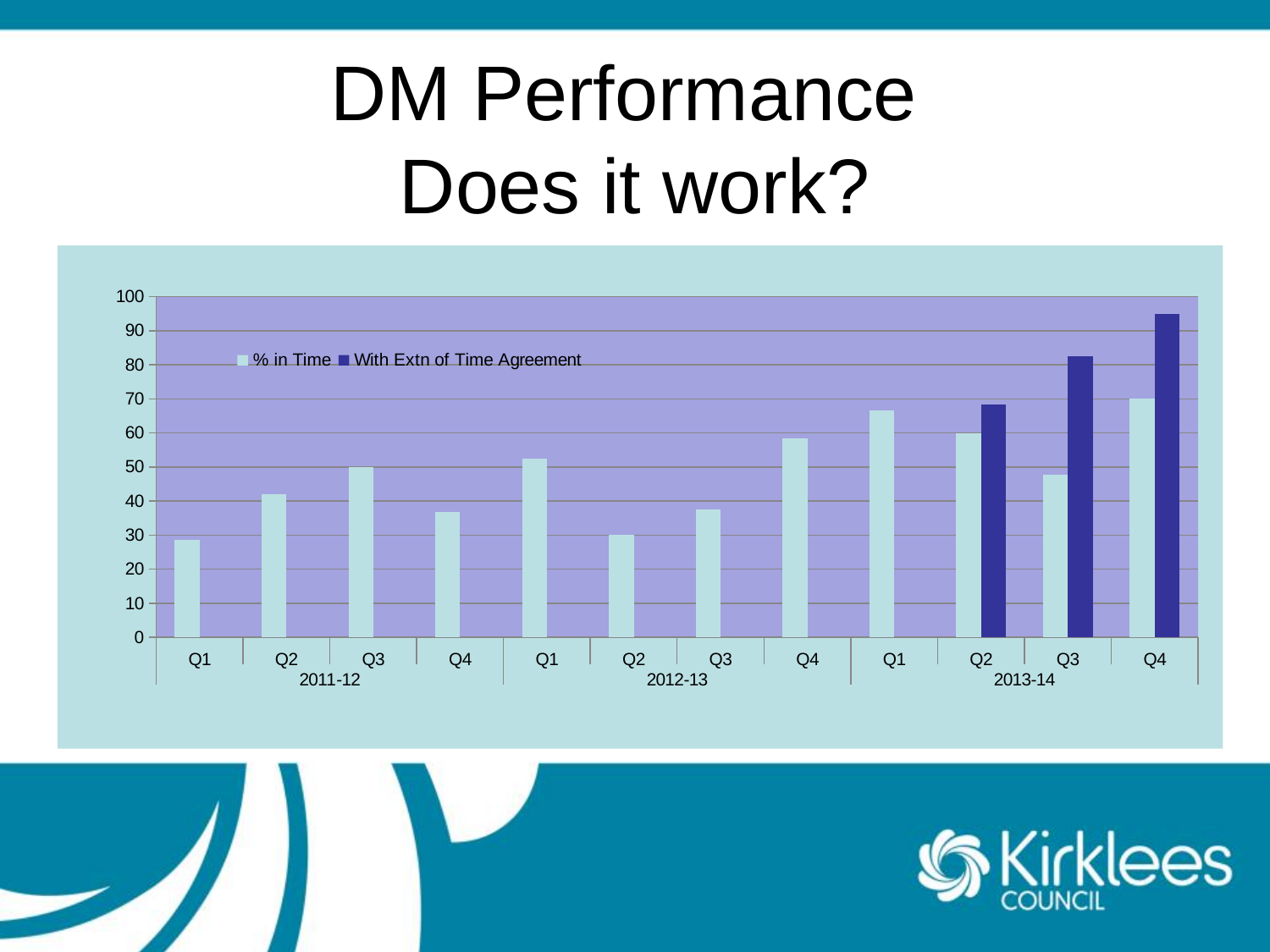
How many quarters are plotted along the x axis? 12 What kind of chart is shown on the slide? bar chart How many series does the legend list? 2 Is the 'With Extn of Time Agreement' value for Q4 2013-14 greater or less than 90? greater Is the '% in Time' value for Q1 2011-12 greater or less than 40? less Which quarter has the highest 'With Extn of Time Agreement' value? Q4 2013-14 For how many quarters is a 'With Extn of Time Agreement' bar shown? 3 Do the 'With Extn of Time Agreement' values rise or fall from Q2 to Q4 of 2013-14? rise Is the '% in Time' value for Q2 2012-13 greater or less than 40? less What are the two series named in the legend? % in Time; With Extn of Time Agreement In Q3 2013-14, which is larger: '% in Time' or 'With Extn of Time Agreement'? With Extn of Time Agreement Which has the larger '% in Time' value: Q4 2012-13 or Q2 2012-13? Q4 2012-13